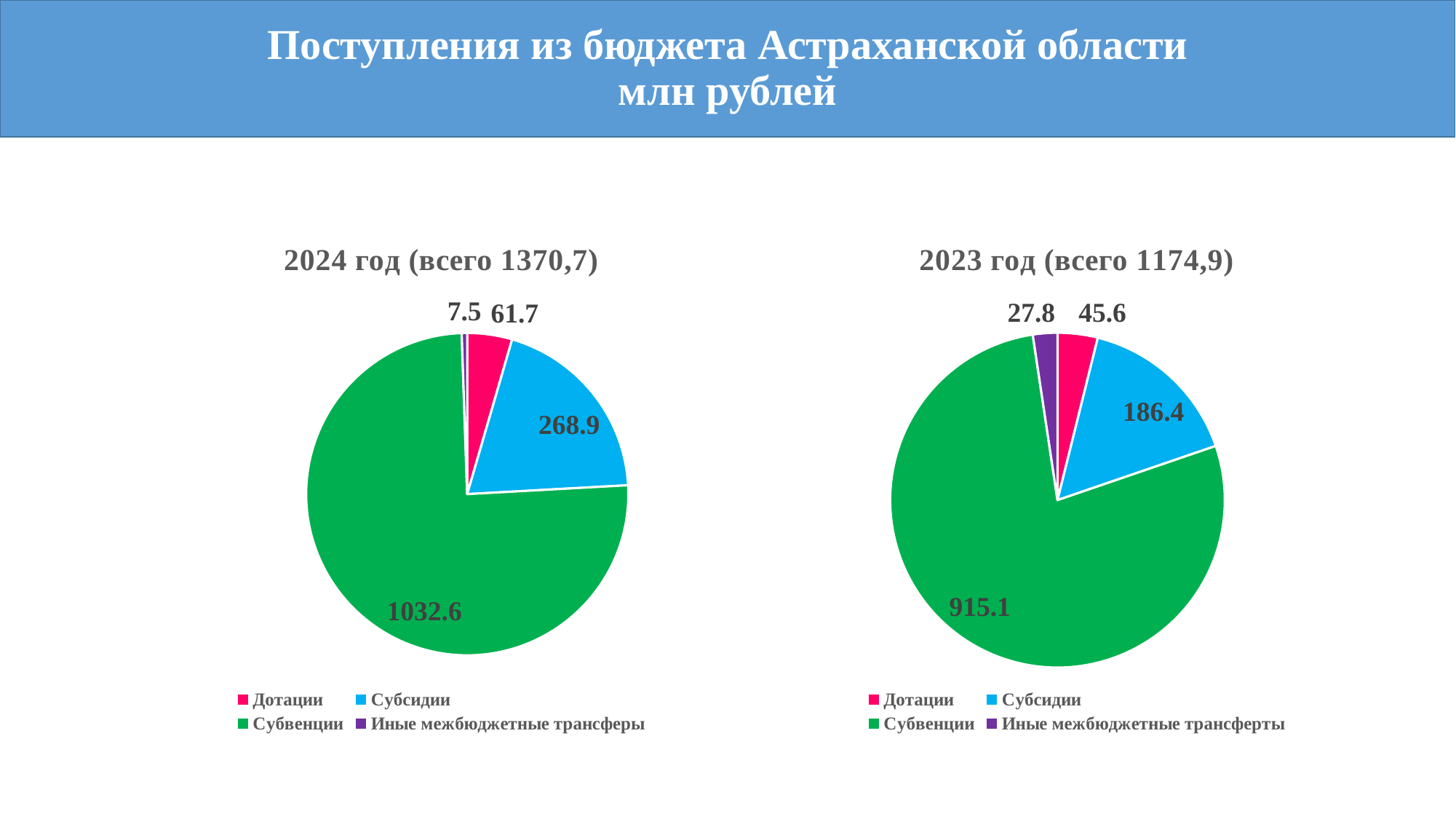
What type of chart is used on this slide? Pie chart In the chart titled "2023 год (всего 1174,9)", which category has the smallest slice? Иные межбюджетные трансферты In the chart titled "2023 год (всего 1174,9)", what is the value for Дотации? 45.6 How many categories does the legend of the chart titled "2024 год (всего 1370,7)" list? 4 In the chart titled "2023 год (всего 1174,9)", what is the value for Субсидии? 186.4 Is the Дотации value larger in the 2024 chart or in the 2023 chart? 2024 In the chart titled "2023 год (всего 1174,9)", what colour is the Субсидии slice? Blue In the chart titled "2024 год (всего 1370,7)", what is the value for Иные межбюджетные трансферы? 7.5 What is the difference between the Субсидии value in the 2024 chart and the Субсидии value in the 2023 chart? 82.5 In the chart titled "2024 год (всего 1370,7)", which category has the largest slice? Субвенции In the chart titled "2024 год (всего 1370,7)", what is the value for Субвенции? 1032.6 What is the difference between the Субвенции value in the 2024 chart and the Субвенции value in the 2023 chart? 117.5